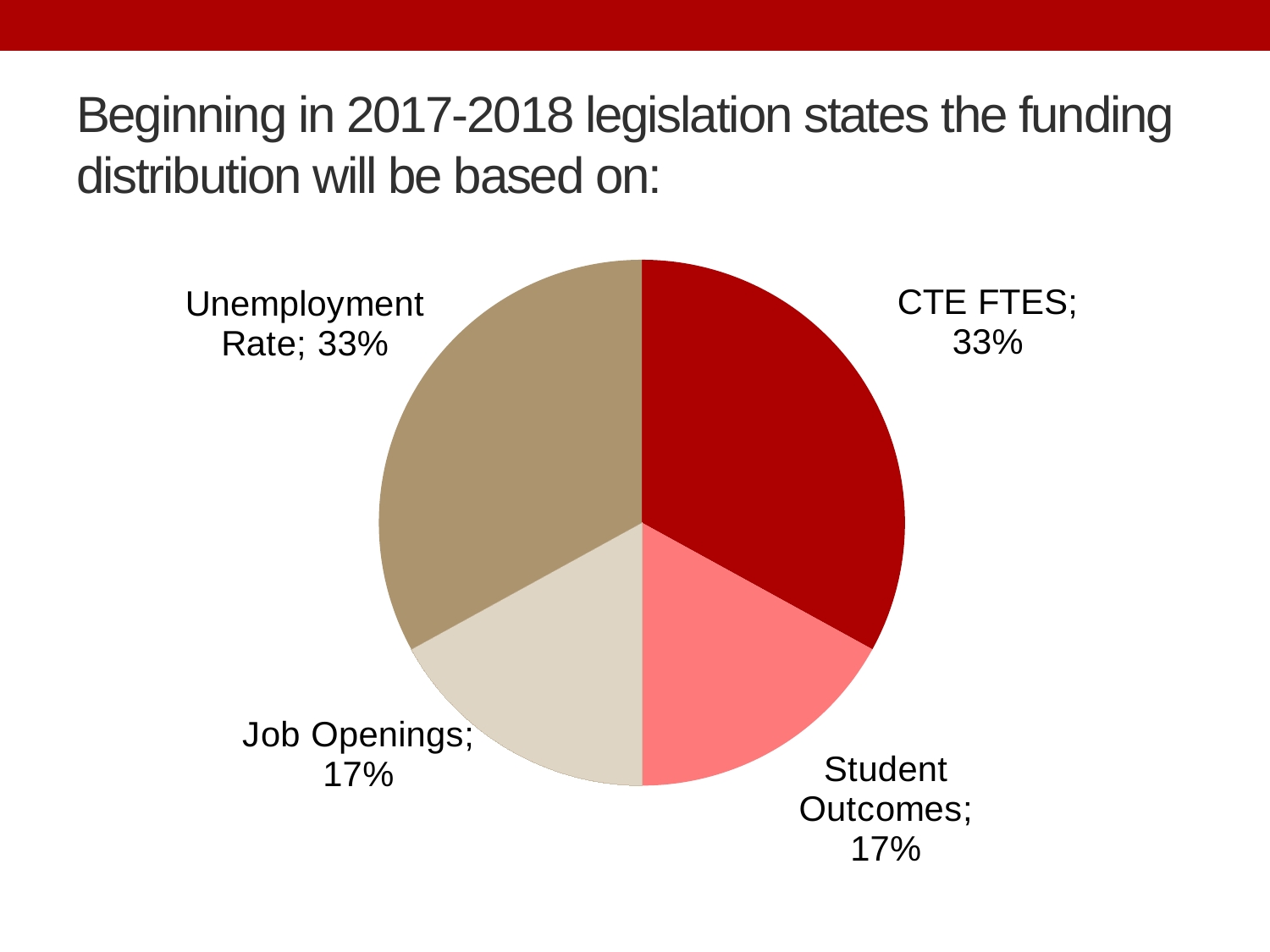
How many slices does the pie chart have? 4 What share of the pie does Job Openings represent? 17% Which is larger, the share for Job Openings or the share for Unemployment Rate? Unemployment Rate What share of the pie does Unemployment Rate represent? 33% What is the difference in percentage points between the CTE FTES share and the Student Outcomes share? 16 What is the difference in percentage points between the Unemployment Rate share and the Job Openings share? 16 What kind of chart is shown on the slide? pie chart Which is larger, the share for CTE FTES or the share for Student Outcomes? CTE FTES Which slice of the pie chart is coloured dark red? CTE FTES What share of the pie does Student Outcomes represent? 17% What is the title text above the pie chart? Beginning in 2017-2018 legislation states the funding distribution will be based on: